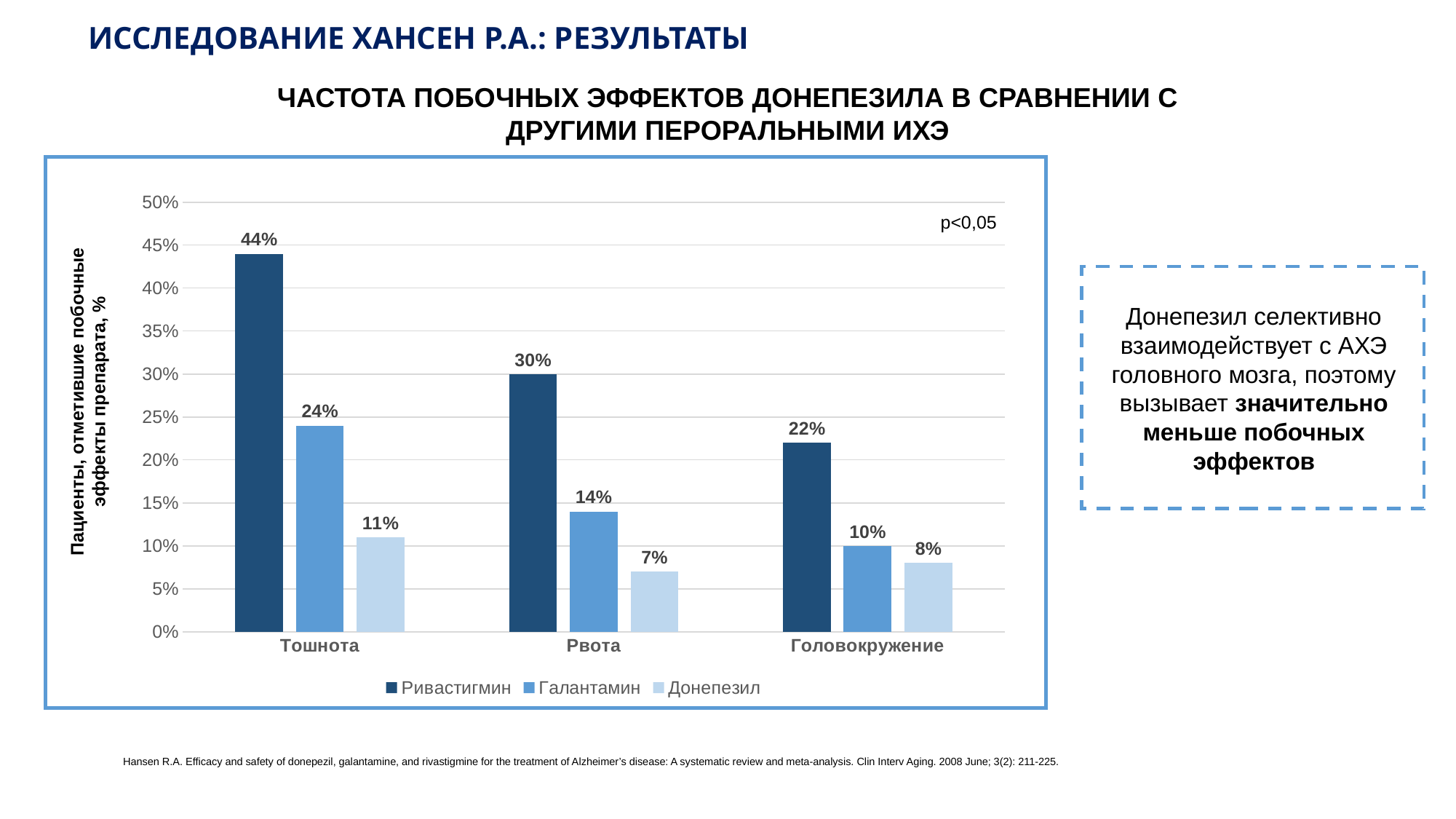
Which series has the highest value in the Тошнота category? Ривастигмин What is the difference between Галантамин and Донепезил in the Рвота category? 7% How many series does the legend list? 3 Which series has the lowest value in the Головокружение category? Донепезил What kind of chart is shown on the slide? Bar chart What is the value for Донепезил in the Рвота category? 7% Which is larger: Галантамин for Тошнота or Ривастигмин for Головокружение? Галантамин for Тошнота What p-value is printed on the chart? p<0,05 What is the value for Галантамин in the Головокружение category? 10% What is the value for Ривастигмин in the Тошнота category? 44% What is the difference between Ривастигмин and Донепезил in the Тошнота category? 33% How many side-effect categories are shown on the x axis? 3